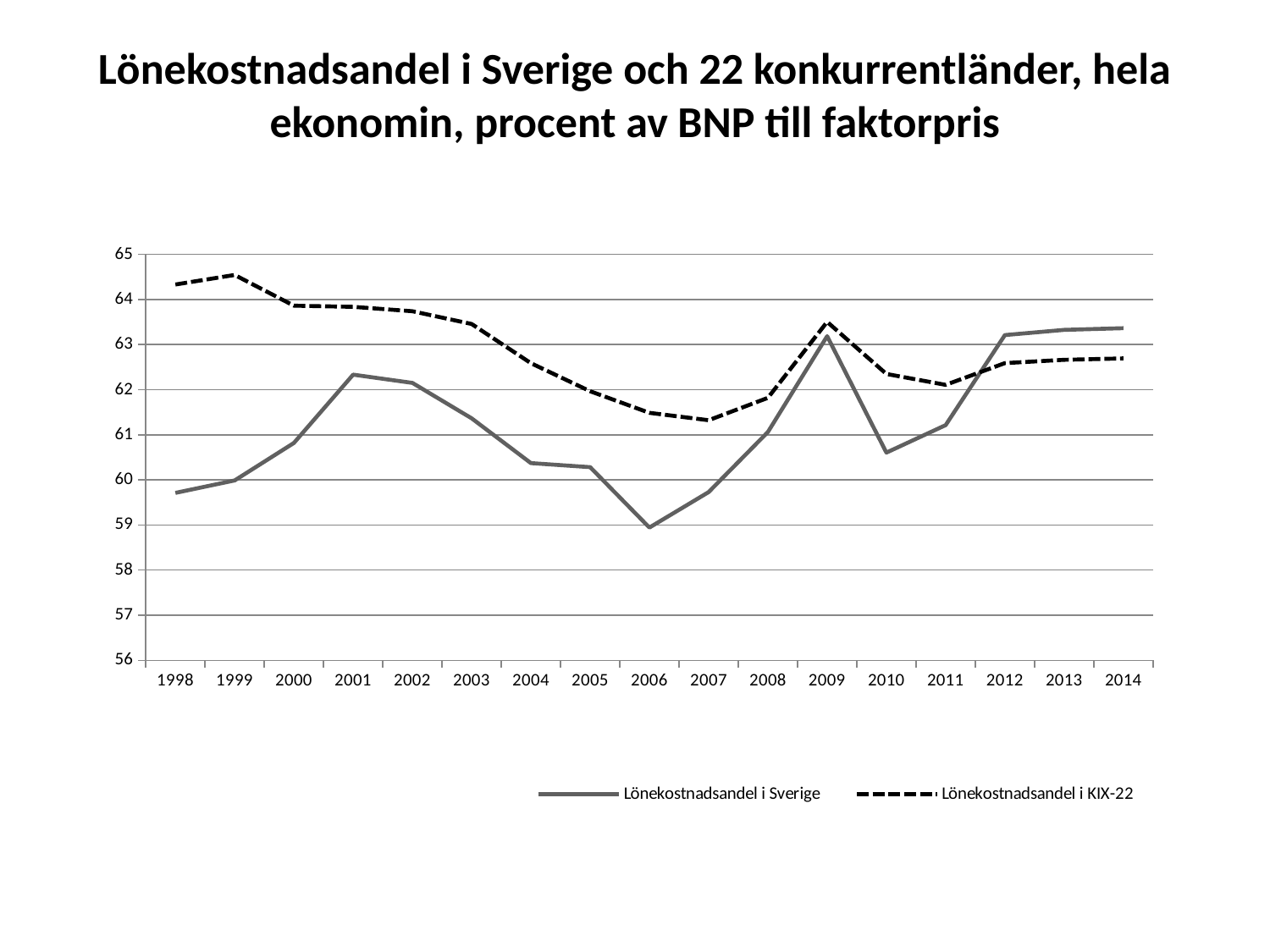
What kind of chart is shown on the slide? line chart In which year is the value for Lönekostnadsandel i Sverige lowest? 2006 In 2012, which series has the higher value, Lönekostnadsandel i Sverige or Lönekostnadsandel i KIX-22? Lönekostnadsandel i Sverige How many years are plotted along the x axis? 17 Which series is drawn with a dashed line? Lönekostnadsandel i KIX-22 Is the value for Lönekostnadsandel i KIX-22 in 1998 greater or less than 64? greater How many series does the legend list? 2 Is the value for Lönekostnadsandel i Sverige in 2001 greater or less than 62? greater In 2003, which series has the higher value, Lönekostnadsandel i Sverige or Lönekostnadsandel i KIX-22? Lönekostnadsandel i KIX-22 Does the value for Lönekostnadsandel i KIX-22 rise or fall from 1999 to 2007? fall In which year is the value for Lönekostnadsandel i KIX-22 highest? 1999